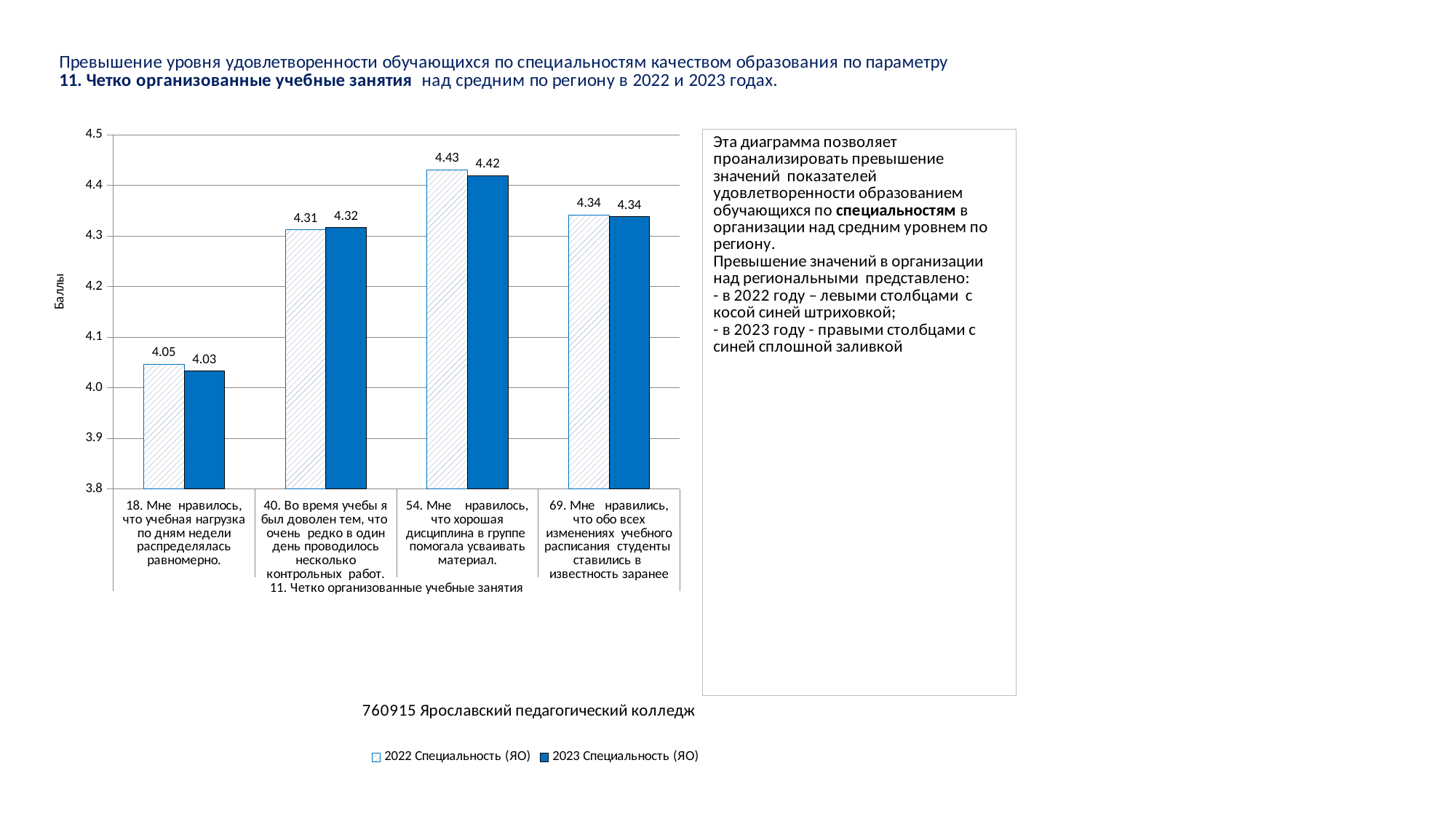
What is the value of the 2023 Специальность (ЯО) series for category 40 (Во время учебы я был доволен тем, что очень редко в один день проводилось несколько контрольных работ)? 4.32 Is the 2023 Специальность (ЯО) value for category 69 greater or less than 4.3? greater Which category has the highest value in the 2022 Специальность (ЯО) series? 54. Мне нравилось, что хорошая дисциплина в группе помогала усваивать материал. What is the value of the 2022 Специальность (ЯО) series for category 18 (Мне нравилось, что учебная нагрузка по дням недели распределялась равномерно)? 4.05 How many series does the chart legend list? 2 What is the value of the 2023 Специальность (ЯО) series for category 54 (Мне нравилось, что хорошая дисциплина в группе помогала усваивать материал)? 4.42 What type of chart is shown on the slide? Bar chart What is the label of the vertical axis of the chart? Баллы How many categories are shown on the x axis of the chart? 4 Which category has the lowest value in the 2023 Специальность (ЯО) series? 18. Мне нравилось, что учебная нагрузка по дням недели распределялась равномерно. For category 54, which series has the larger value: 2022 Специальность (ЯО) or 2023 Специальность (ЯО)? 2022 Специальность (ЯО) What is the difference between the 2022 and 2023 values for category 18? 0.02